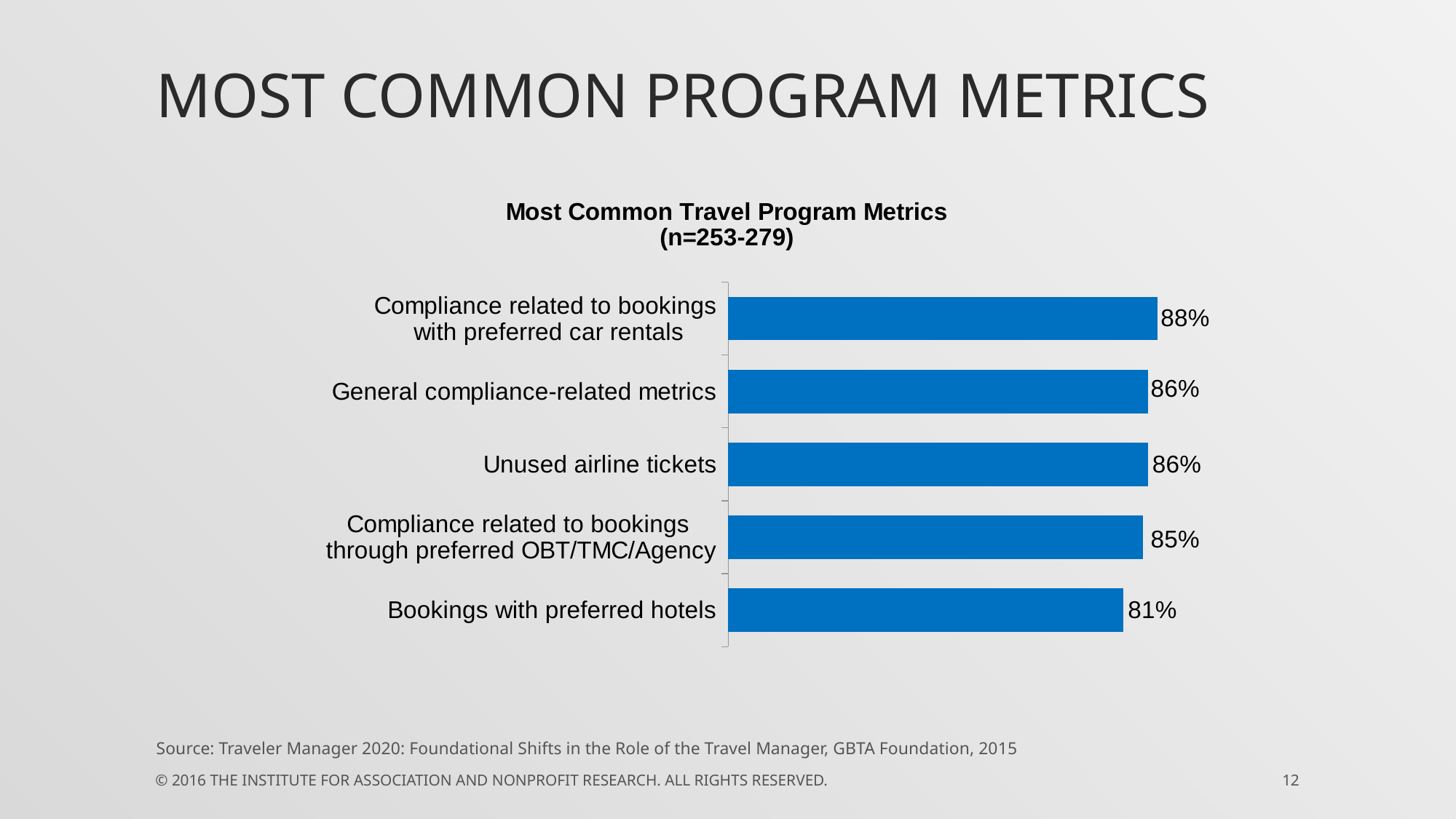
What is the difference between the values for General compliance-related metrics and Compliance related to bookings through preferred OBT/TMC/Agency? 1% What is the value for Compliance related to bookings with preferred car rentals? 88% What is the title of the chart? Most Common Travel Program Metrics (n=253-279) What is the value for Compliance related to bookings through preferred OBT/TMC/Agency? 85% How many categories are shown in the chart? 5 What is the value for Unused airline tickets? 86% Which is larger: the value for Unused airline tickets or the value for Bookings with preferred hotels? Unused airline tickets What is the difference between the values for Compliance related to bookings with preferred car rentals and Bookings with preferred hotels? 7% What is the value for Bookings with preferred hotels? 81% What kind of chart is shown on the slide? Bar chart Which category has the lowest value? Bookings with preferred hotels Which category has the highest value? Compliance related to bookings with preferred car rentals